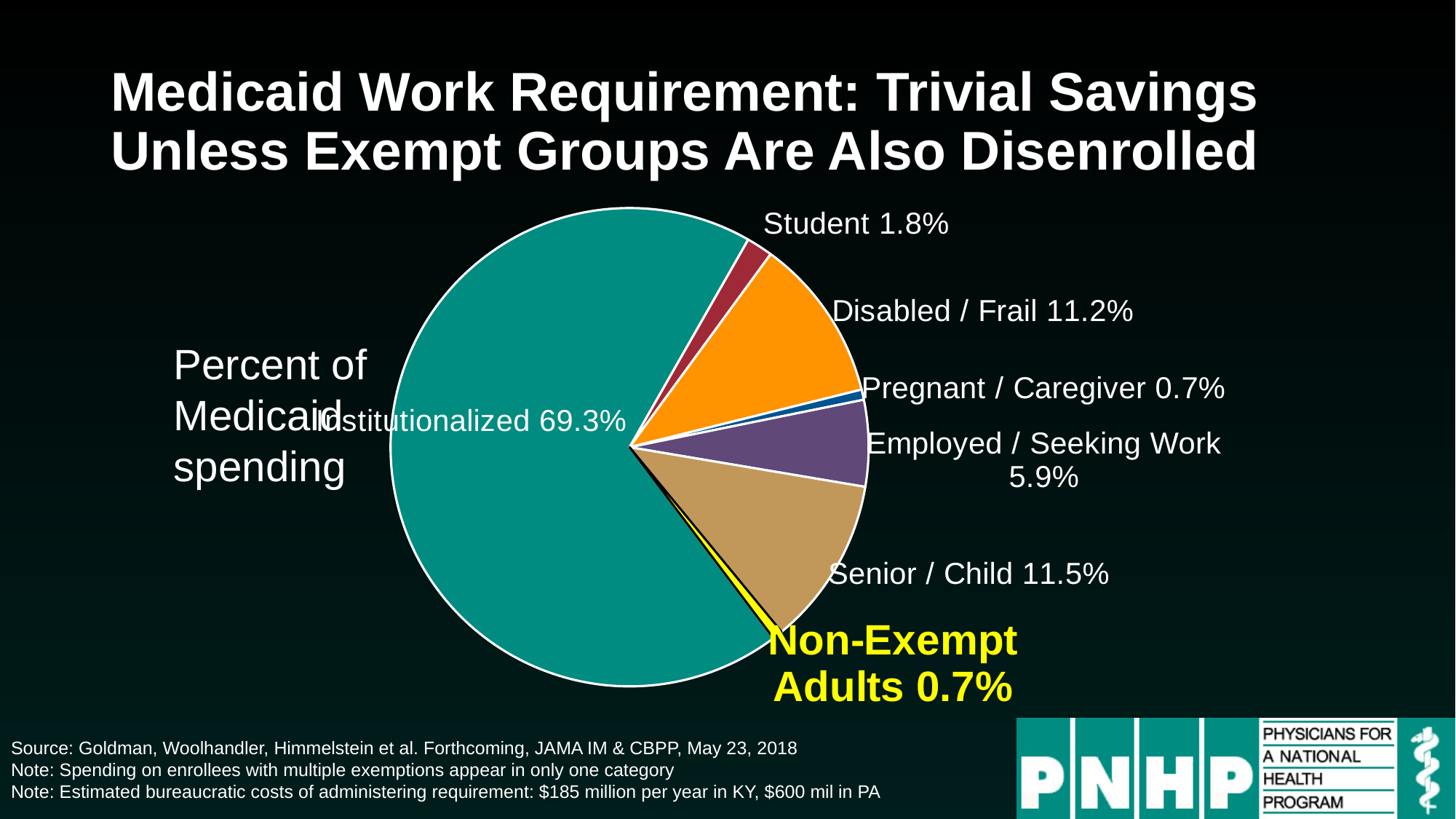
What percentage of Medicaid spending is attributed to Institutionalized enrollees? 69.3% What is the value shown for Employed / Seeking Work? 5.9% What share of Medicaid spending goes to Non-Exempt Adults? 0.7% Which is larger, the share for Senior / Child or the share for Disabled / Frail? Senior / Child How many categories are shown in the pie chart? 7 Which category accounts for the largest share of Medicaid spending? Institutionalized What is the value shown for Student? 1.8% What is the value shown for Disabled / Frail? 11.2% What is the difference in percentage points between Institutionalized and Senior / Child? 57.8 What type of chart is shown on the slide? Pie chart What is the difference in percentage points between Disabled / Frail and Employed / Seeking Work? 5.3 Which category's label is highlighted in yellow on the chart? Non-Exempt Adults